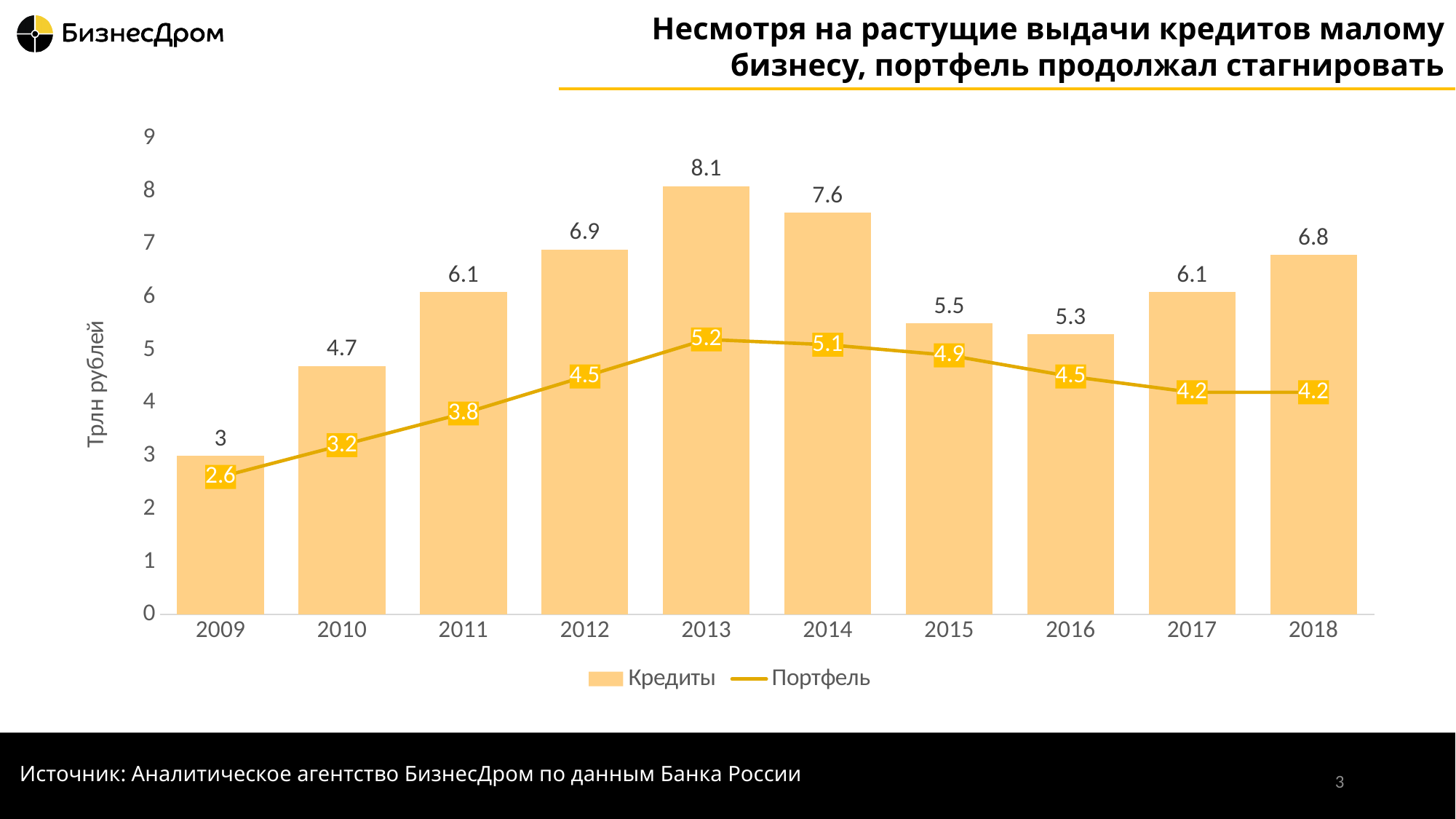
Which year has the lowest value of Портфель? 2009 How many years are shown on the x axis? 10 What is the value of Кредиты for 2018? 6.8 What is the value of Портфель for 2011? 3.8 What is the difference between Кредиты and Портфель in 2014? 2.5 How many series does the legend list? 2 What kind of chart is shown on the slide? Combined bar and line chart Which is larger in 2016: Кредиты or Портфель? Кредиты Does the Портфель series rise or fall from 2013 to 2018? Fall What is the label of the y axis? Трлн рублей Which year has the highest value of Кредиты? 2013 What is the value of Кредиты for 2013? 8.1